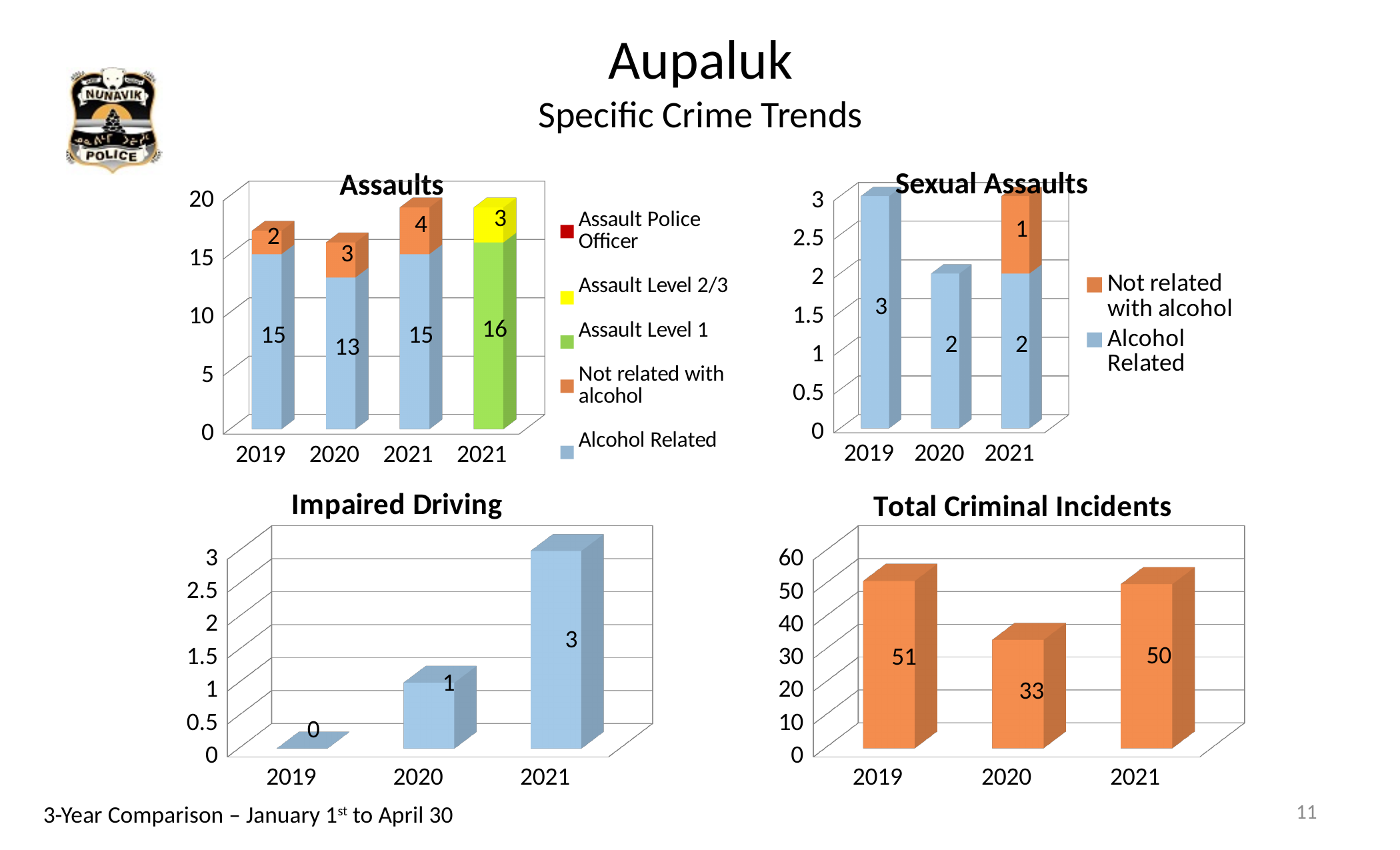
In the Assaults chart, how many series does the legend list? 5 In the Assaults chart, what is the Alcohol Related value for 2020? 13 In the Impaired Driving chart, what is the value for 2021? 3 In the Assaults chart, what is the total of the stacked bar for 2020? 16 What kind of chart is the Total Criminal Incidents chart? bar chart In the Total Criminal Incidents chart, which year has the highest value? 2019 In the Total Criminal Incidents chart, what is the difference between the 2019 and 2020 values? 18 In the Total Criminal Incidents chart, what is the value for 2020? 33 In the Sexual Assaults chart, what is the Not related with alcohol value for 2021? 1 In the Impaired Driving chart, which year has the lowest value? 2019 In the Impaired Driving chart, do the values rise or fall from 2019 to 2021? rise In the Sexual Assaults chart, is the Alcohol Related value for 2019 larger or smaller than the Alcohol Related value for 2020? larger